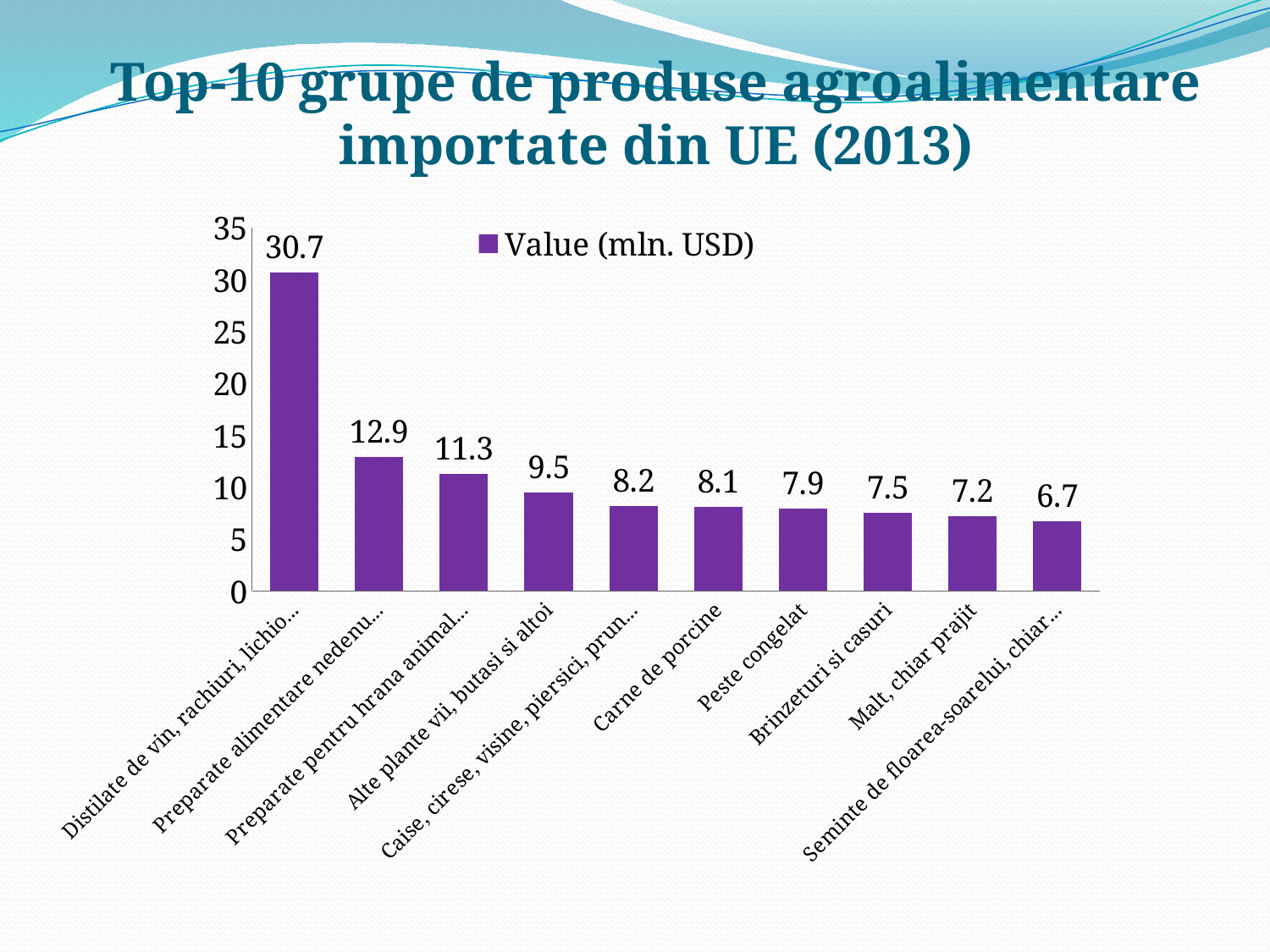
What is the value for Malt, chiar prajit? 7.2 What kind of chart is shown on the slide? Bar chart Is the value for Preparate alimentare nedenu... greater or less than 10? greater How many categories are shown in the chart? 10 What is the value for Carne de porcine? 8.1 What is the difference between the highest value (30.7) and the value for Alte plante vii, butasi si altoi (9.5)? 21.2 Which category has the highest value? Distilate de vin, rachiuri, lichio... What is the value for Brinzeturi si casuri? 7.5 Which category has the lowest value? Seminte de floarea-soarelui, chiar... Which is larger, the value for Carne de porcine or the value for Malt, chiar prajit? Carne de porcine What is the value for Peste congelat? 7.9 What is the legend entry of the series shown in the chart? Value (mln. USD)